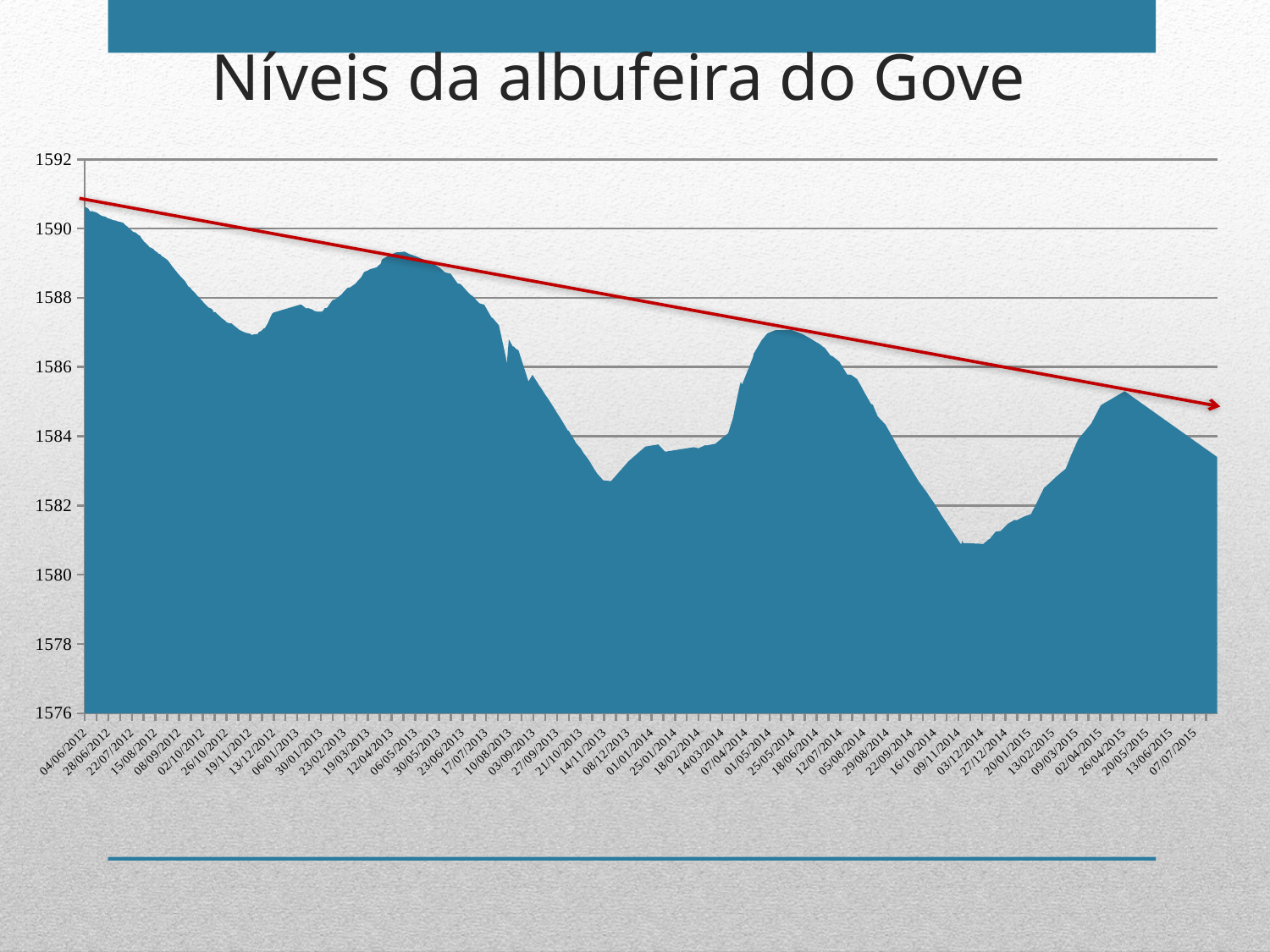
Which date has the highest reservoir level on the chart? 04/06/2012 Is the value for 25/05/2014 greater or less than 1586? greater Overall, do the reservoir levels rise or fall from the start of the x axis to the end? fall What is the title of the chart? Níveis da albufeira do Gove Is the value for 26/04/2015 greater or less than 1584? greater Which is larger, the value for 04/06/2012 or the value for 07/07/2015? 04/06/2012 Is the value for 07/07/2015 greater or less than 1586? less What colour is the straight trend arrow drawn over the chart? red What kind of chart is shown on the slide? area chart